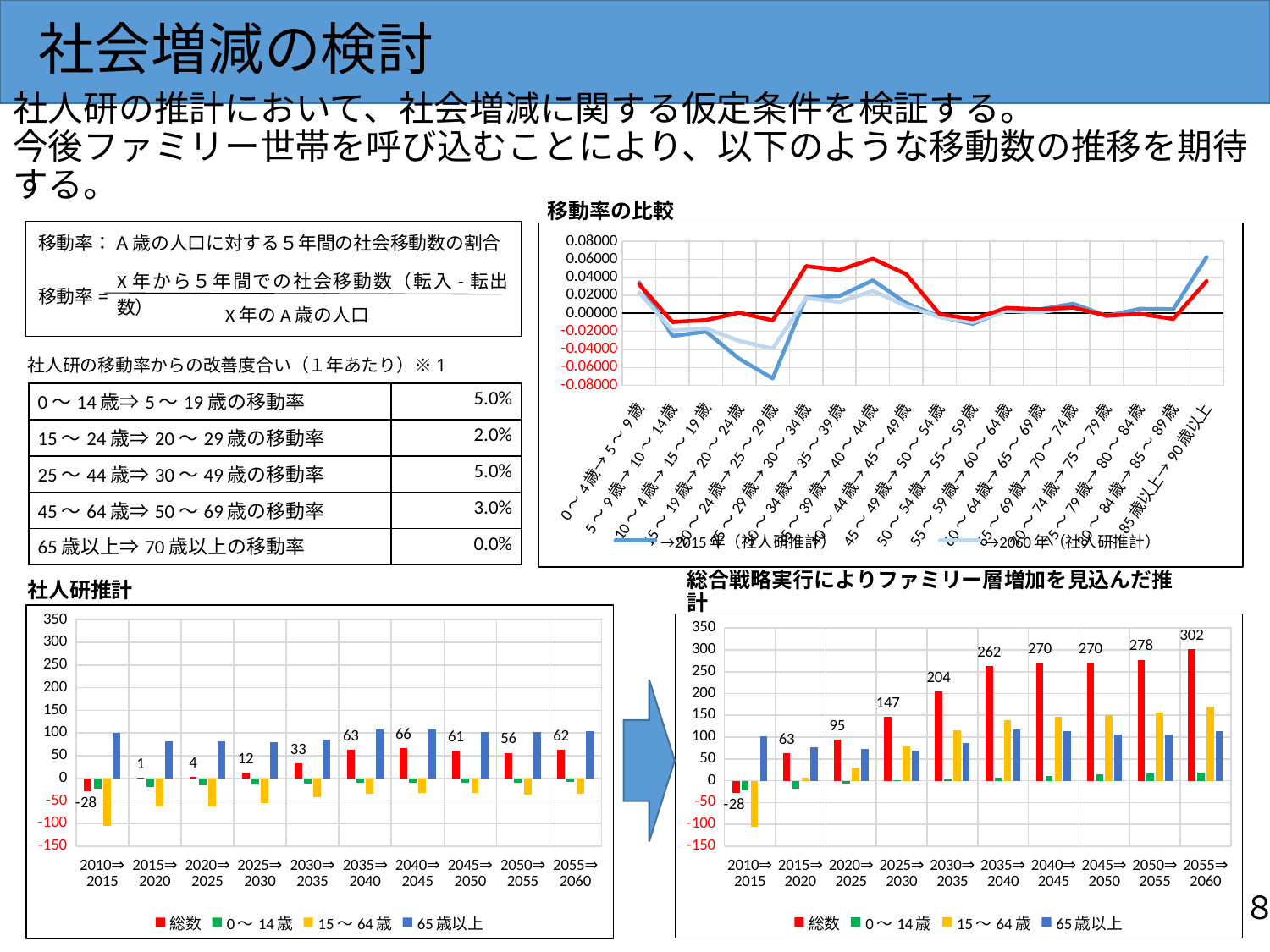
How many series does the legend of the 社人研推計 chart list? 4 In the 総合戦略実行によりファミリー層増加を見込んだ推計 chart, what is the 総数 value for 2055⇒2060? 302 In the 総合戦略実行によりファミリー層増加を見込んだ推計 chart, what is the difference between the 総数 values for 2055⇒2060 and 2050⇒2055? 24 In the 社人研推計 chart, what is the 総数 value for 2010⇒2015? -28 Which is larger: the 総数 value for 2040⇒2045 in the 社人研推計 chart or in the 総合戦略実行によりファミリー層増加を見込んだ推計 chart? 総合戦略実行によりファミリー層増加を見込んだ推計 In the 総合戦略実行によりファミリー層増加を見込んだ推計 chart, which period has the highest 総数 value? 2055⇒2060 What kind of chart is the 移動率の比較 chart? Line chart In the 社人研推計 chart, what is the difference between the 総数 values for 2035⇒2040 and 2030⇒2035? 30 In the 社人研推計 chart, which period has the highest 総数 value? 2040⇒2045 In the 社人研推計 chart, which period has the lowest 総数 value? 2010⇒2015 In the 社人研推計 chart, what is the 総数 value for 2055⇒2060? 62 In the 総合戦略実行によりファミリー層増加を見込んだ推計 chart, what is the 総数 value for 2030⇒2035? 204